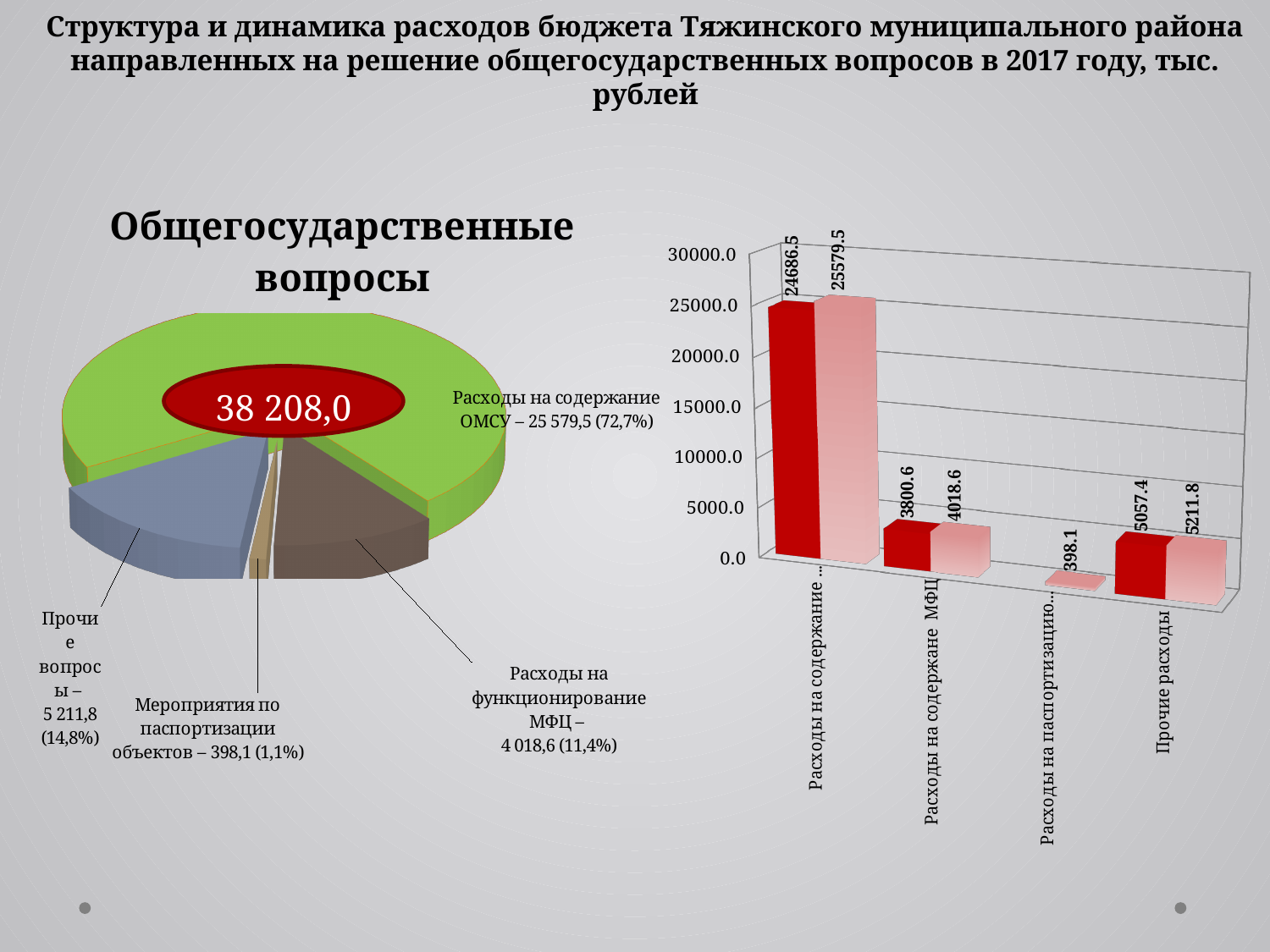
In the pie chart 'Общегосударственные вопросы', what is the value for 'Прочие вопросы'? 5 211,8 What kind of chart is the chart on the right side of the slide? bar chart In the pie chart 'Общегосударственные вопросы', which is larger: 'Расходы на функционирование МФЦ' or 'Прочие вопросы'? Прочие вопросы In the bar chart on the right, what is the difference between the light pink bar and the dark red bar for 'Прочие расходы'? 154.4 In the pie chart 'Общегосударственные вопросы', what is the value for 'Мероприятия по паспортизации объектов'? 398,1 What number is shown in the red oval at the centre of the pie chart 'Общегосударственные вопросы'? 38 208,0 How many slices does the pie chart 'Общегосударственные вопросы' have? 4 In the bar chart on the right, is the dark red bar for 'Расходы на содержане МФЦ' greater or less than 5000.0? less In the pie chart 'Общегосударственные вопросы', which slice is the smallest? Мероприятия по паспортизации объектов In the bar chart on the right, what is the value of the light pink bar for 'Прочие расходы'? 5211.8 In the pie chart 'Общегосударственные вопросы', what share of the total is 'Расходы на содержание ОМСУ'? 72,7% In the pie chart 'Общегосударственные вопросы', which slice is the largest? Расходы на содержание ОМСУ